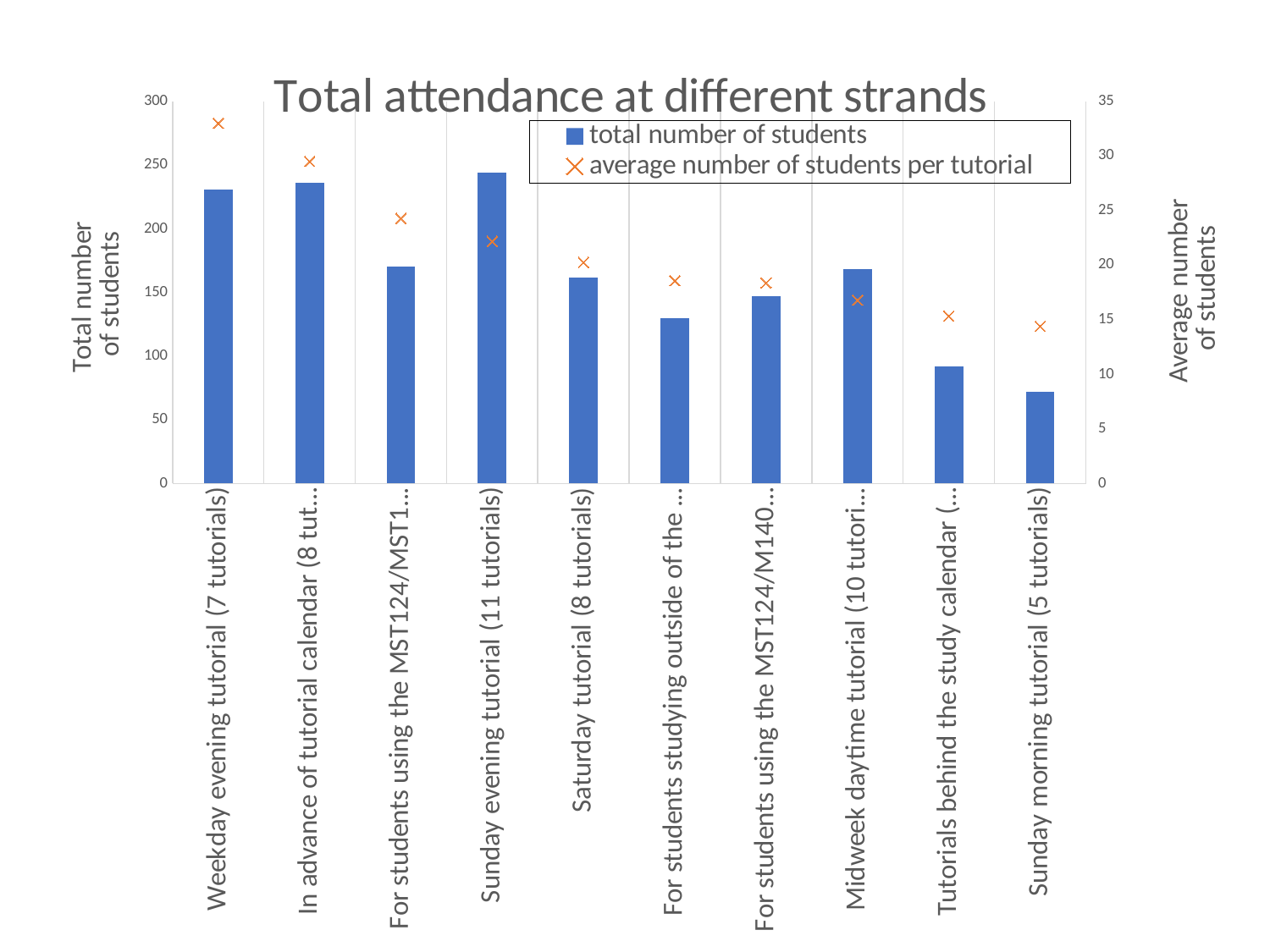
What is the title of the chart? Total attendance at different strands Is the total number of students for Sunday morning tutorial (5 tutorials) greater or less than 100? less Which has the larger total number of students: Saturday tutorial (8 tutorials) or Sunday evening tutorial (11 tutorials)? Sunday evening tutorial (11 tutorials) How many series does the legend list? 2 Which strand has the lowest total number of students? Sunday morning tutorial (5 tutorials) Is the total number of students for Weekday evening tutorial (7 tutorials) greater or less than 200? greater Which strand has the highest average number of students per tutorial? Weekday evening tutorial (7 tutorials) What kind of chart is used to show the total number of students? Bar chart Is the average number of students per tutorial for Weekday evening tutorial (7 tutorials) greater or less than 30? greater Which strand has the highest total number of students? Sunday evening tutorial (11 tutorials) How many strands (categories) are plotted on the x axis? 10 What is the title of the right-hand vertical axis? Average number of students